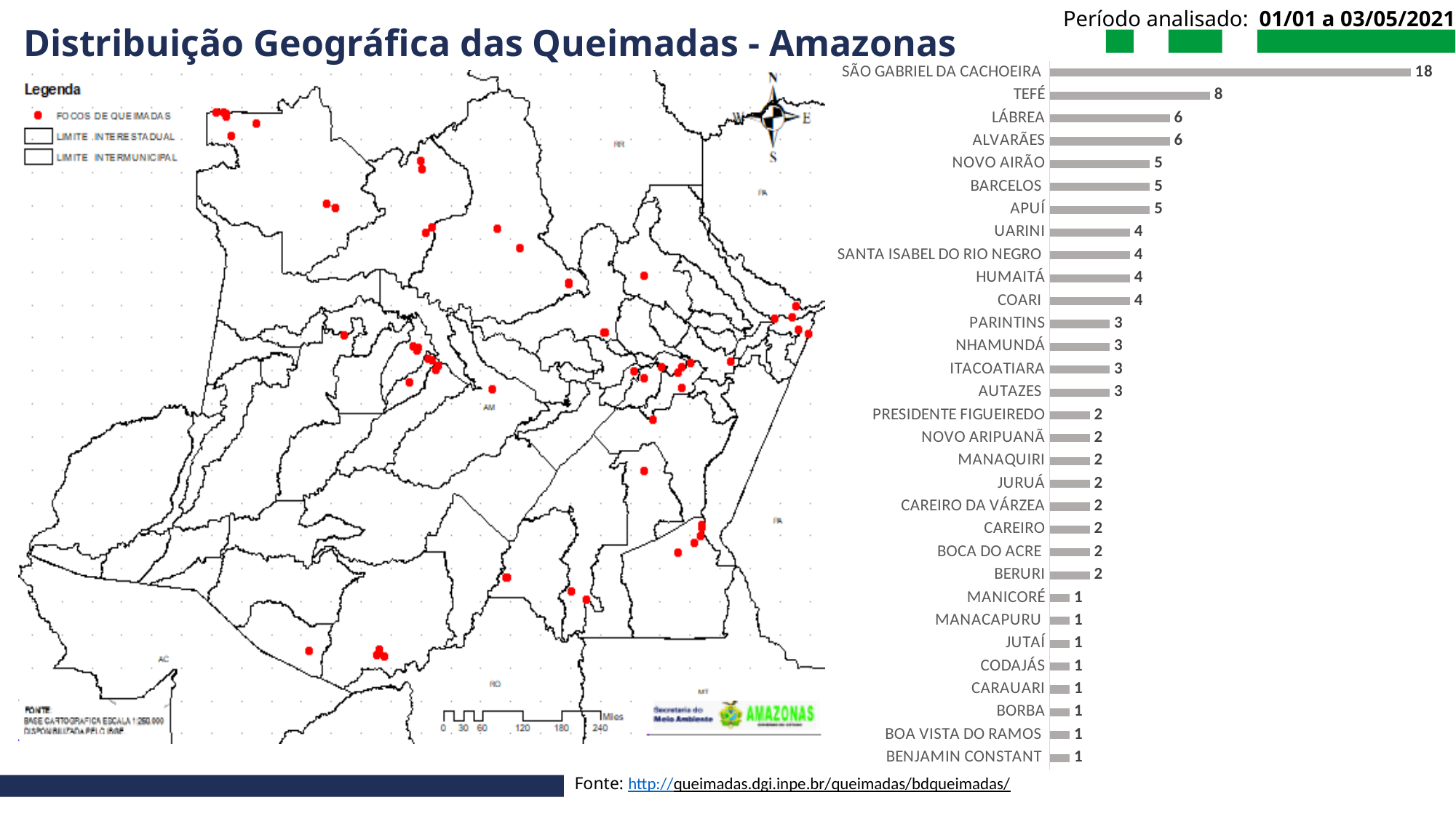
What is the difference between the values for SÃO GABRIEL DA CACHOEIRA and TEFÉ? 10 What is the difference between the values for LÁBREA and PARINTINS? 3 Which has a larger value, NOVO AIRÃO or UARINI? NOVO AIRÃO What kind of chart is shown on the right side of the slide? bar chart How many municipalities are listed in the bar chart? 31 What is the value for TEFÉ in the bar chart? 8 What is the value for SÃO GABRIEL DA CACHOEIRA in the bar chart? 18 What is the value for BOCA DO ACRE in the bar chart? 2 Which has a larger value, MANICORÉ or BERURI? BERURI What is the value for HUMAITÁ in the bar chart? 4 What period is analysed according to the slide? 01/01 a 03/05/2021 Which municipality has the highest value in the bar chart? SÃO GABRIEL DA CACHOEIRA